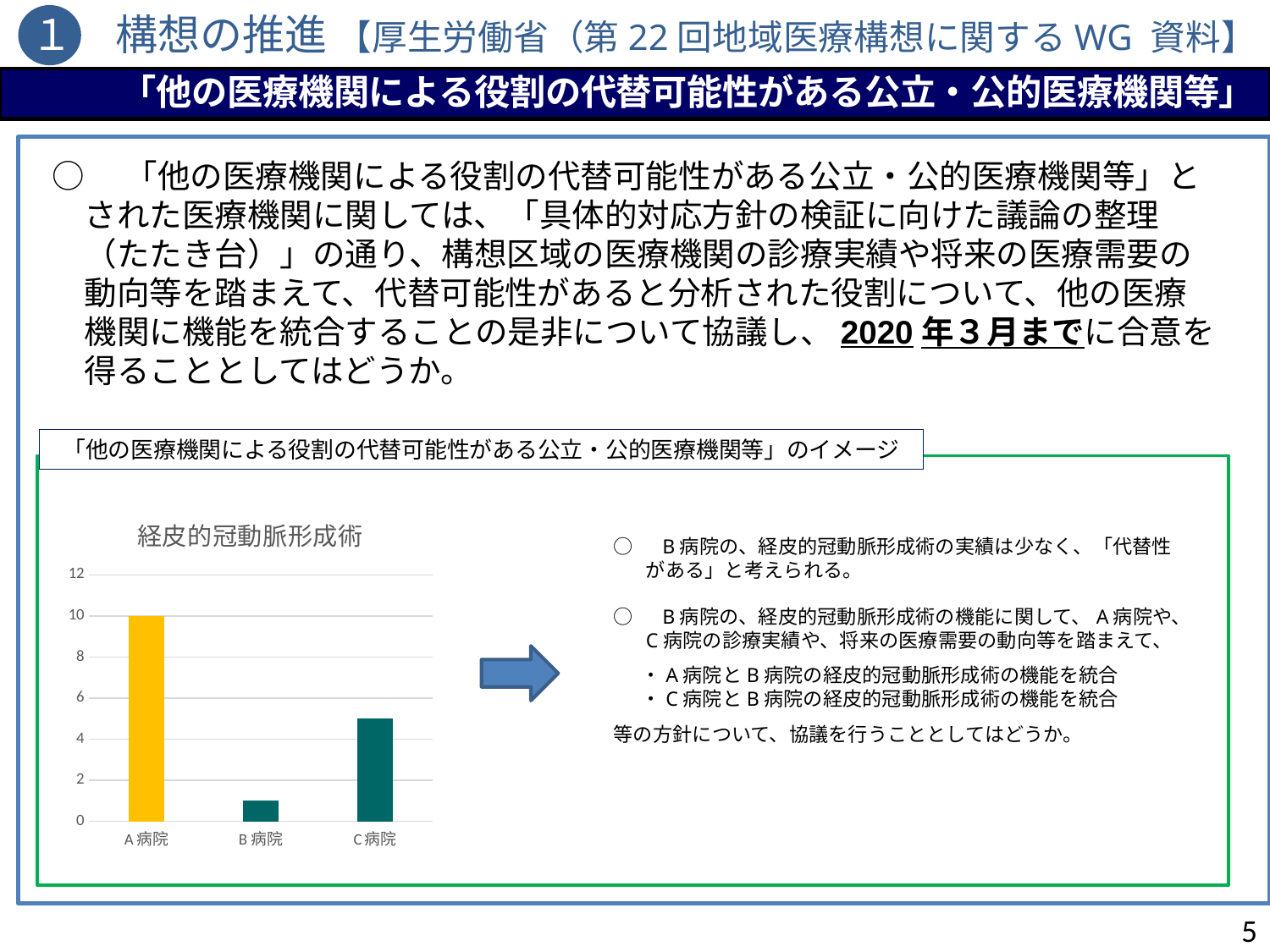
How many hospitals (categories) are shown in the chart? 3 What is the title of the chart? 経皮的冠動脈形成術 Which is larger, the value for A病院 or the value for C病院? A病院 Which is larger, the value for C病院 or the value for B病院? C病院 What is the highest value shown on the vertical axis of the chart? 12 What is the value for A病院? 10 What type of chart is shown on the slide? bar chart Is the value for C病院 greater or less than 4? greater Is the value for B病院 greater or less than 2? less Which hospital has the highest value in the chart? A病院 Which hospital has the lowest value in the chart? B病院 Is the value for C病院 greater or less than 6? less